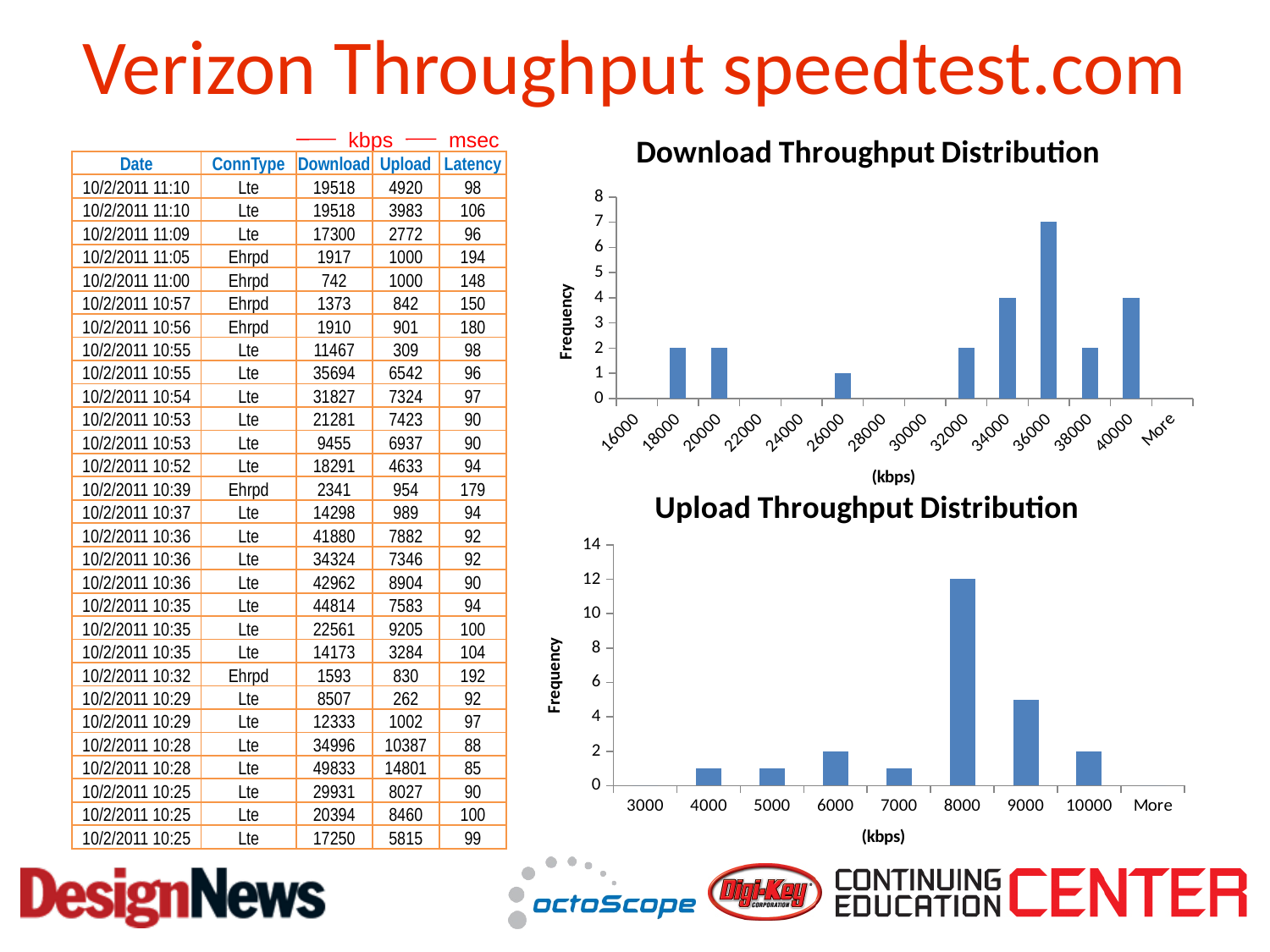
In the Upload Throughput Distribution chart, what is the frequency for the 8000 bin? 12 What kind of chart is the Download Throughput Distribution chart? bar chart In the Upload Throughput Distribution chart, is the frequency for the 9000 bin greater or less than 4? greater How many bins are shown on the x axis of the Download Throughput Distribution chart? 14 How many bins are shown on the x axis of the Upload Throughput Distribution chart? 9 In the Download Throughput Distribution chart, what is the difference between the frequencies of the 36000 and 34000 bins? 3 What is the y-axis label on the Upload Throughput Distribution chart? Frequency In the Download Throughput Distribution chart, what is the frequency for the 36000 bin? 7 In the Download Throughput Distribution chart, what is the frequency for the 34000 bin? 4 In the Download Throughput Distribution chart, which bin has the highest frequency? 36000 In the Upload Throughput Distribution chart, which bin has the highest frequency? 8000 In the Upload Throughput Distribution chart, which bin has the larger frequency, 8000 or 9000? 8000